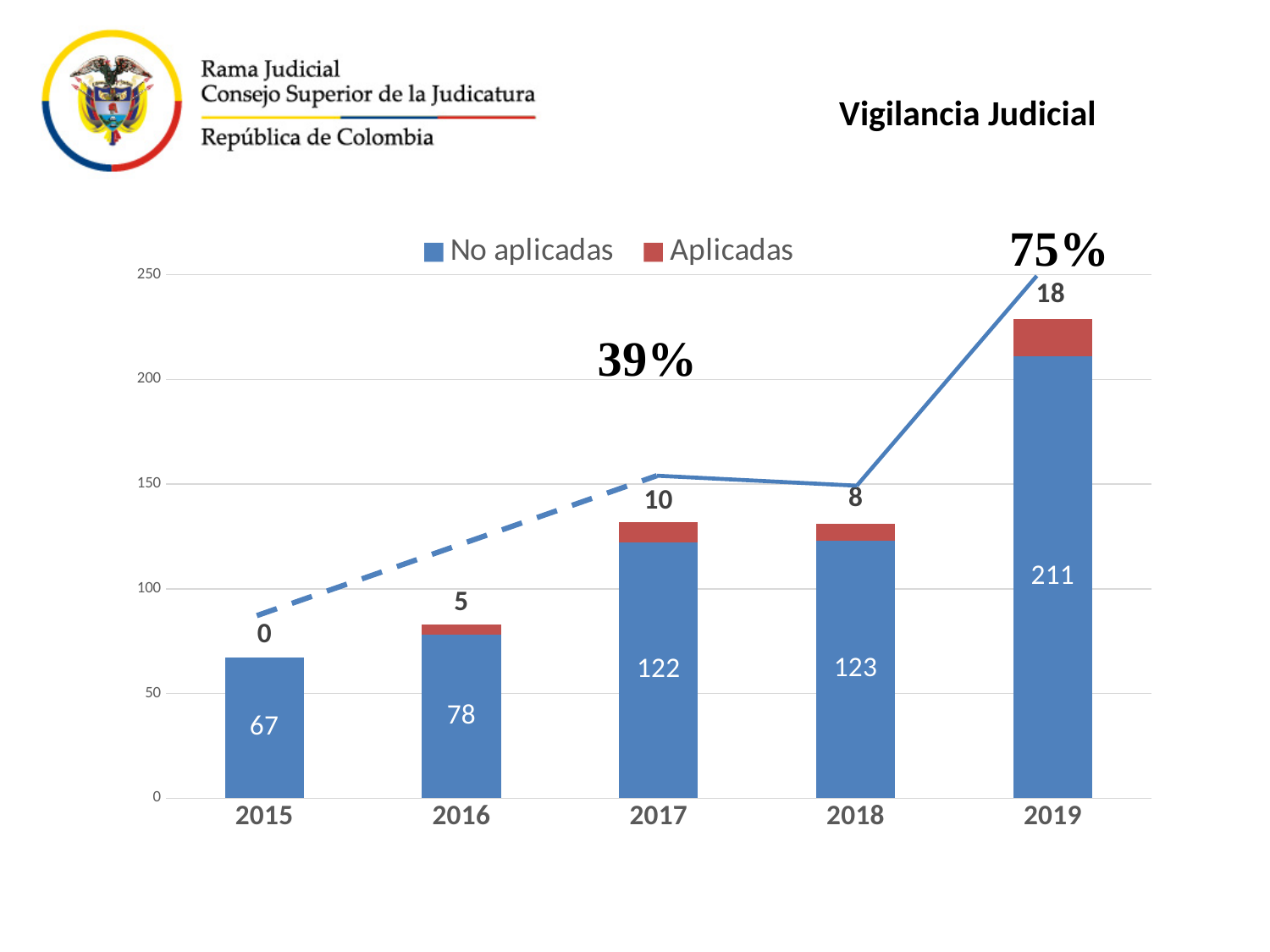
Which year has the lowest value for No aplicadas? 2015 What is the difference between the No aplicadas values for 2019 and 2018? 88 What is the total of the stacked bar for 2016? 83 How many series does the legend list? 2 What is the value of Aplicadas for 2017? 10 What is the value of No aplicadas for 2019? 211 How many years are shown on the x axis? 5 What is the total of the stacked bar for 2019? 229 Which year has the highest value for No aplicadas? 2019 Which is larger, the Aplicadas value for 2018 or for 2019? 2019 What kind of chart is shown on the slide? Stacked bar chart What is the value of Aplicadas for 2015? 0